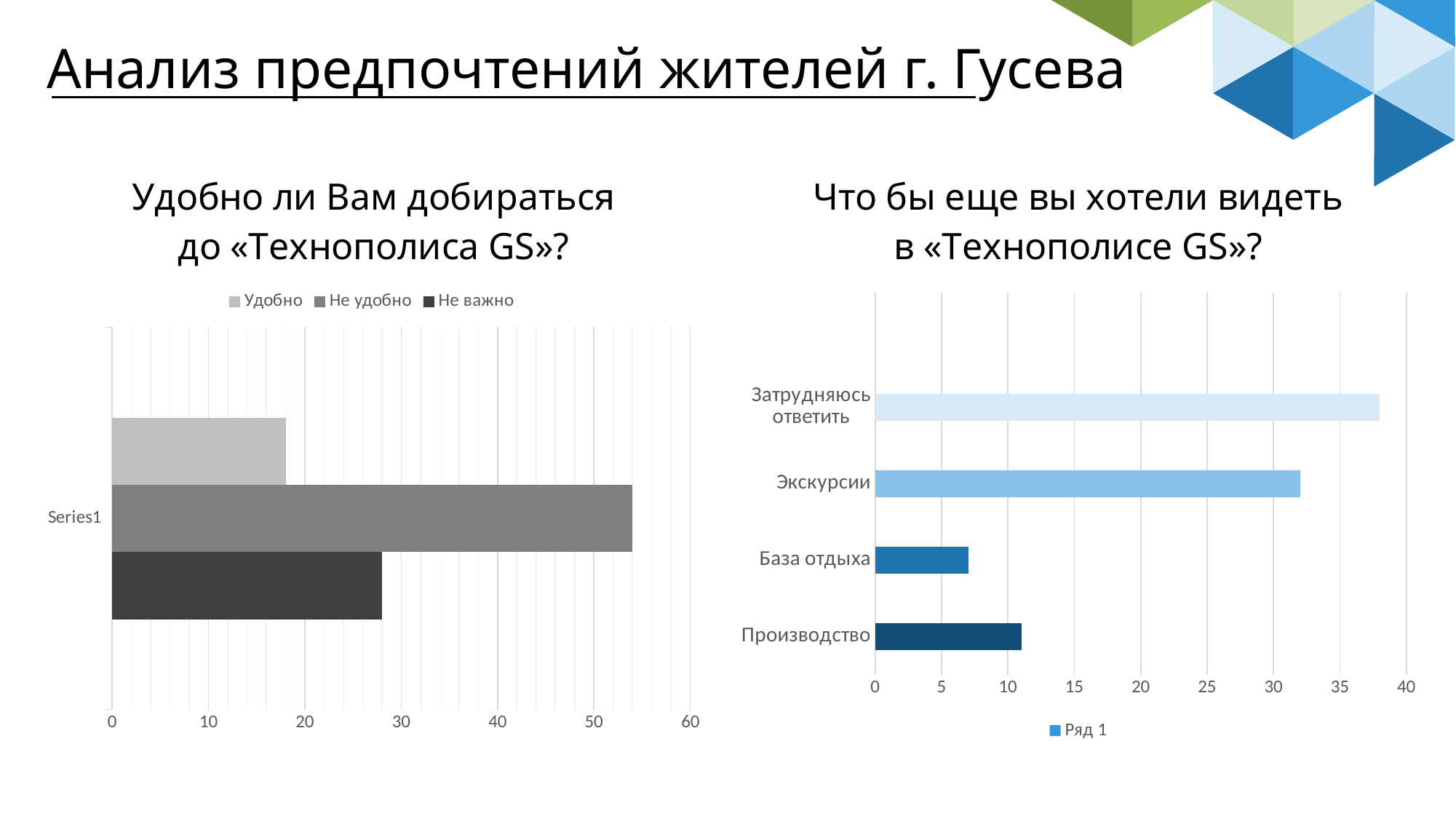
In the chart titled «Удобно ли Вам добираться до «Технополиса GS»?», how many series does the legend list? 3 What type of chart is the one titled «Что бы еще вы хотели видеть в «Технополисе GS»?»? bar chart In the chart titled «Удобно ли Вам добираться до «Технополиса GS»?», is the value for «Не удобно» greater or less than 50? greater In the chart titled «Что бы еще вы хотели видеть в «Технополисе GS»?», which is larger: «Производство» or «База отдыха»? Производство In the chart titled «Что бы еще вы хотели видеть в «Технополисе GS»?», how many categories are shown? 4 In the chart titled «Удобно ли Вам добираться до «Технополиса GS»?», which is larger: «Не важно» or «Удобно»? Не важно In the chart titled «Удобно ли Вам добираться до «Технополиса GS»?», is the value for «Удобно» greater or less than 20? less In the chart titled «Что бы еще вы хотели видеть в «Технополисе GS»?», is the value for «Экскурсии» greater or less than 30? greater In the chart titled «Что бы еще вы хотели видеть в «Технополисе GS»?», which category has the lowest value? База отдыха In the chart titled «Удобно ли Вам добираться до «Технополиса GS»?», which series has the longest bar? Не удобно In the chart titled «Что бы еще вы хотели видеть в «Технополисе GS»?», which category has the highest value? Затрудняюсь ответить In the chart titled «Удобно ли Вам добираться до «Технополиса GS»?», which series has the shortest bar? Удобно